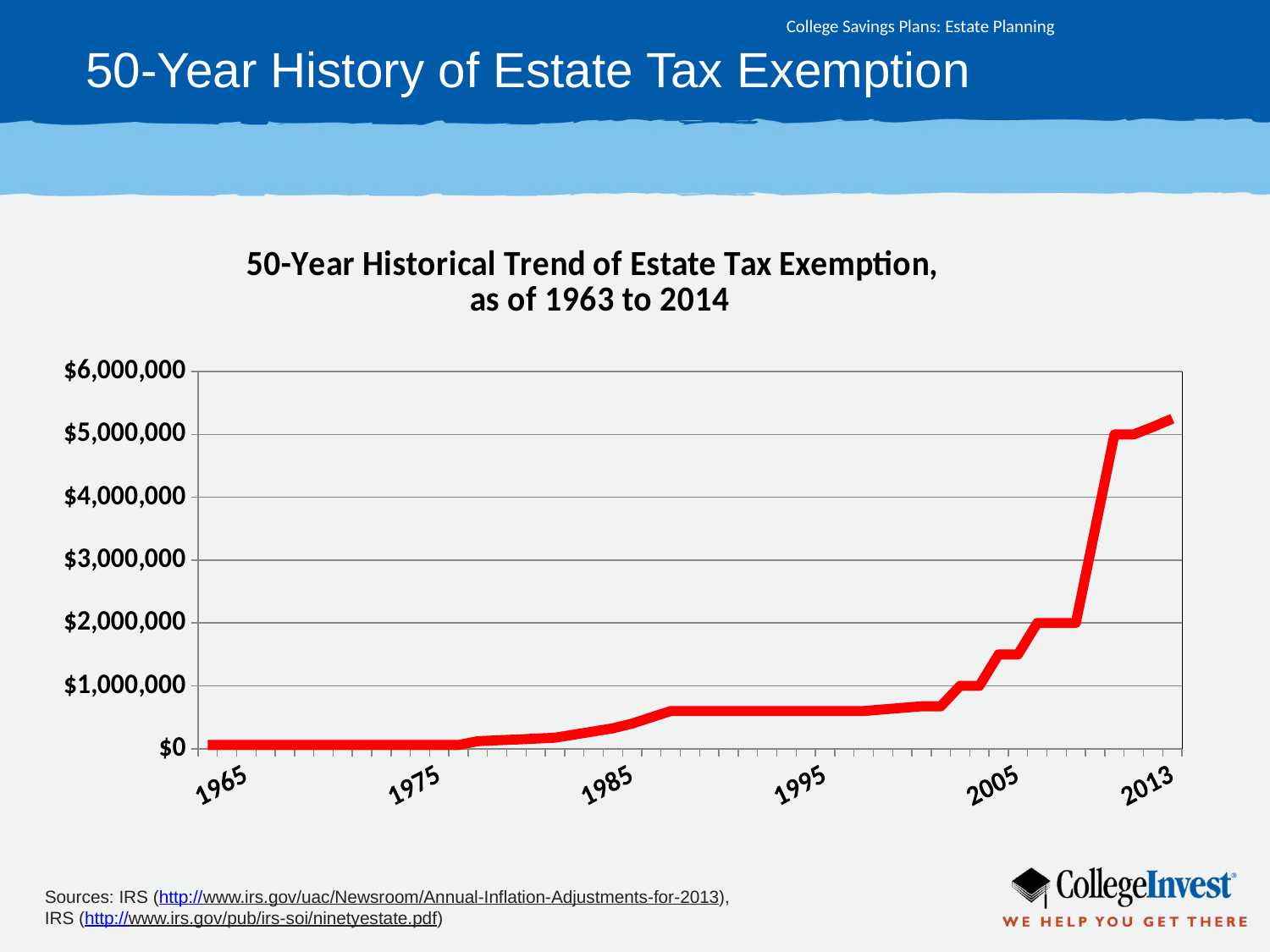
What kind of chart is shown on the slide? line chart Is the value for 1995 greater or less than $1,000,000? less Is the value for 1965 greater or less than $1,000,000? less Is the value for 1985 greater or less than $1,000,000? less What is the title of the chart? 50-Year Historical Trend of Estate Tax Exemption, as of 1963 to 2014 Of the years labeled on the x axis, which has the highest estate tax exemption? 2013 How many year labels are shown on the x axis? 6 Does the estate tax exemption generally rise or fall from 1965 to 2013? rise Which is larger, the value for 2005 or the value for 1995? 2005